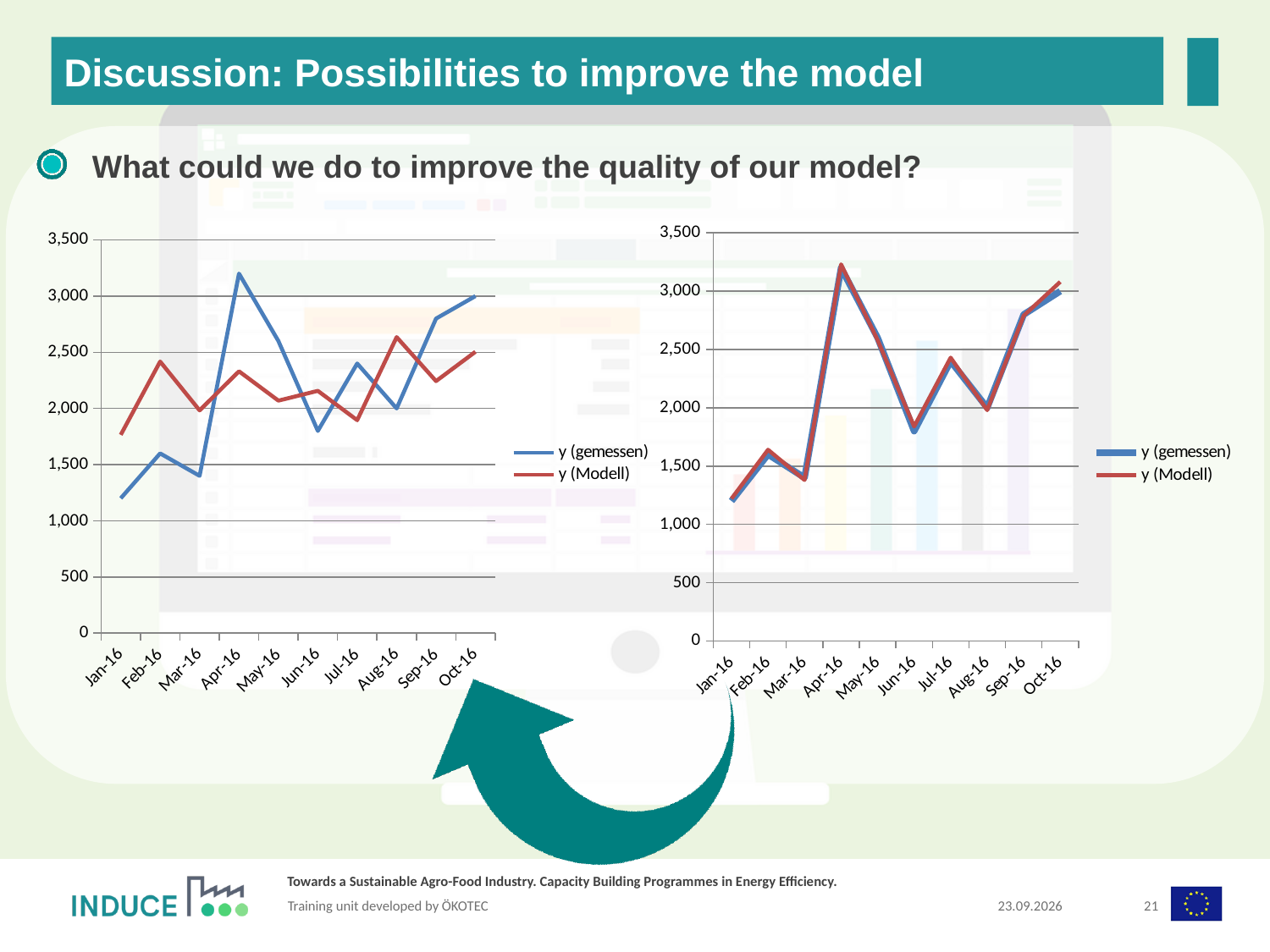
In the chart on the left, does y (gemessen) rise or fall from Aug-16 to Oct-16? rise In the chart on the left, which month has the highest value for y (gemessen)? Apr-16 How many series does the legend of the chart on the right list? 2 What are the two legend entries of the chart on the left? y (gemessen) and y (Modell) In the chart on the left, is the value of y (Modell) for Jan-16 greater or less than 2,000? less In the chart on the right, is the value of y (gemessen) for Jun-16 greater or less than 2,000? less How many months are plotted along the x axis of the chart on the left? 10 In the chart on the left, which month has the lowest value for y (gemessen)? Jan-16 In the chart on the left, which series has the larger value for Feb-16, y (gemessen) or y (Modell)? y (Modell) In the chart on the right, which month has the highest value for y (gemessen)? Apr-16 In the chart on the left, is the value of y (gemessen) for Apr-16 greater or less than 3,000? greater What kind of chart is the chart on the left of the slide? line chart